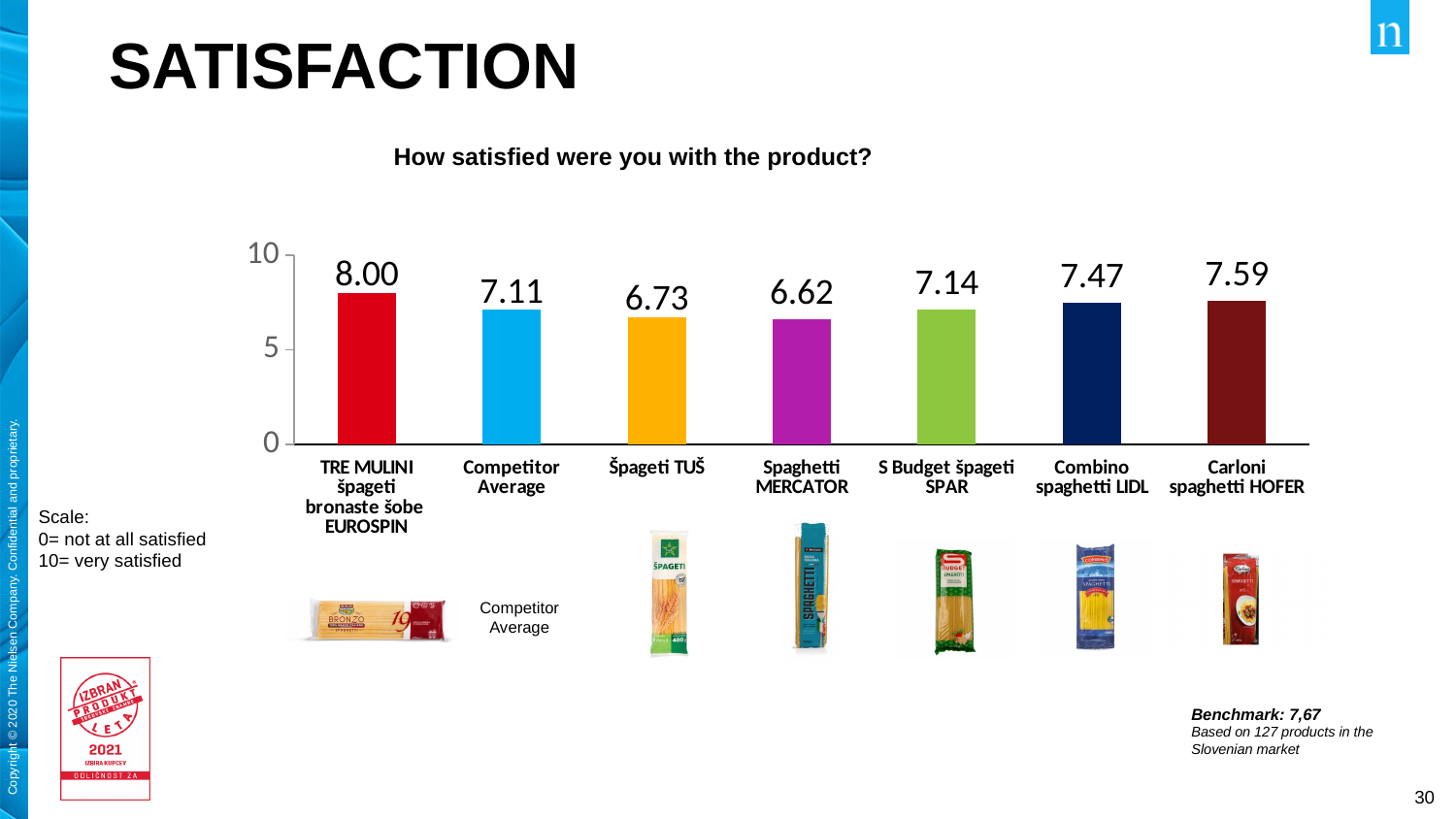
How many bars are shown in the chart? 7 What is the satisfaction score for Spaghetti MERCATOR? 6.62 What is the satisfaction score for Combino spaghetti LIDL? 7.47 What is the satisfaction score for Competitor Average? 7.11 What is the satisfaction score for TRE MULINI špageti bronaste šobe EUROSPIN? 8.00 Is the satisfaction score for Špageti TUŠ greater or less than 5? greater What question is the chart based on, as shown in its title? How satisfied were you with the product? What type of chart is shown on the slide? Bar chart What is the difference between the satisfaction scores of TRE MULINI špageti bronaste šobe EUROSPIN and Competitor Average? 0.89 Which product has the highest satisfaction score? TRE MULINI špageti bronaste šobe EUROSPIN Which has a higher satisfaction score, Carloni spaghetti HOFER or S Budget špageti SPAR? Carloni spaghetti HOFER Which product has the lowest satisfaction score? Spaghetti MERCATOR